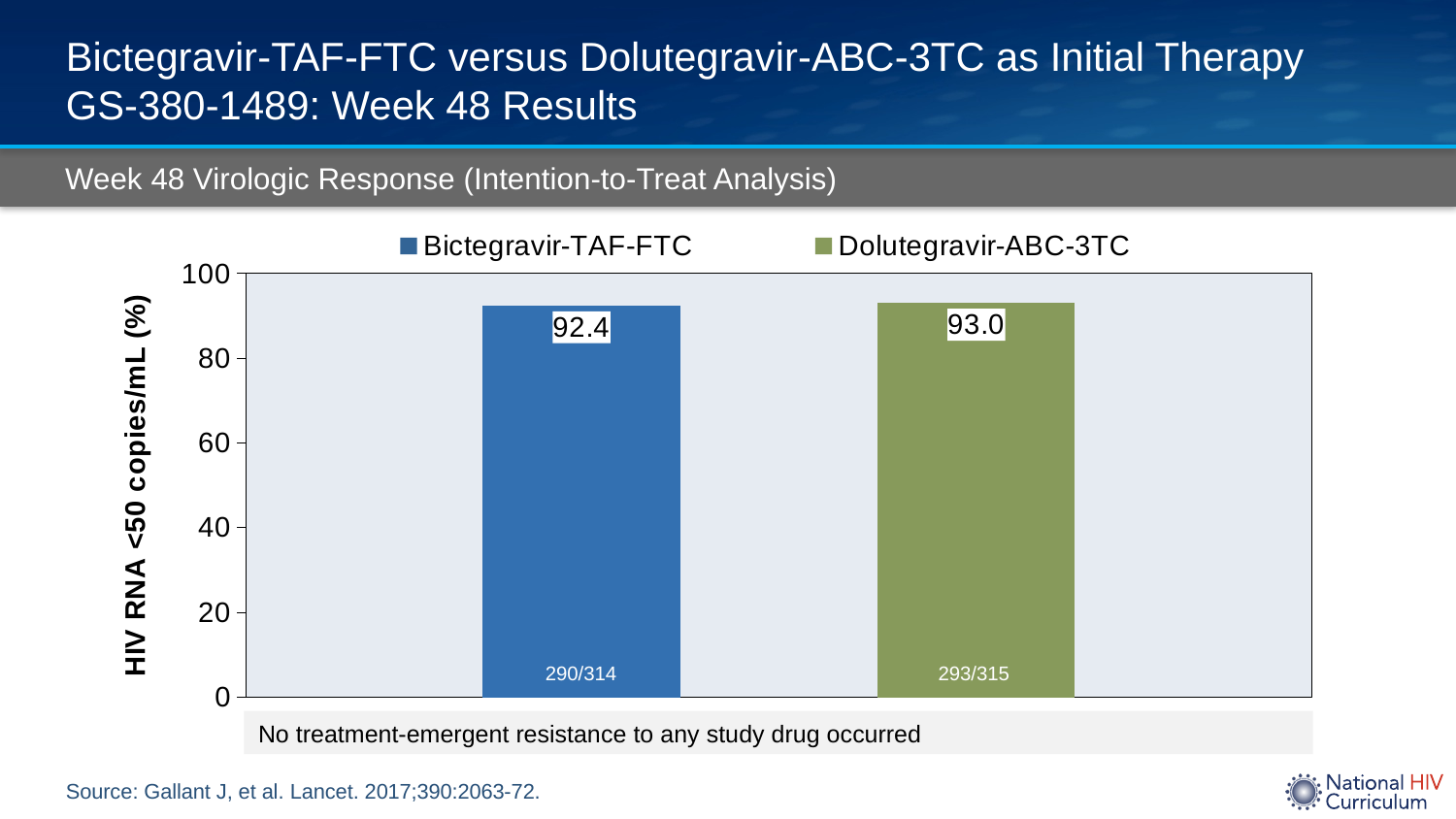
What fraction is printed inside the Dolutegravir-ABC-3TC bar? 293/315 What fraction is printed inside the Bictegravir-TAF-FTC bar? 290/314 What is the difference between the values for Dolutegravir-ABC-3TC and Bictegravir-TAF-FTC? 0.6 Is the value for Dolutegravir-ABC-3TC greater or less than 100? less How many series does the legend list? 2 How many bars are plotted in the chart? 2 Is the value for Bictegravir-TAF-FTC greater or less than 80? greater What is the value for Dolutegravir-ABC-3TC? 93.0 What is the y-axis label of the chart? HIV RNA <50 copies/mL (%) What is the value for Bictegravir-TAF-FTC? 92.4 What is the title of the chart? Week 48 Virologic Response (Intention-to-Treat Analysis) What kind of chart is shown? bar chart